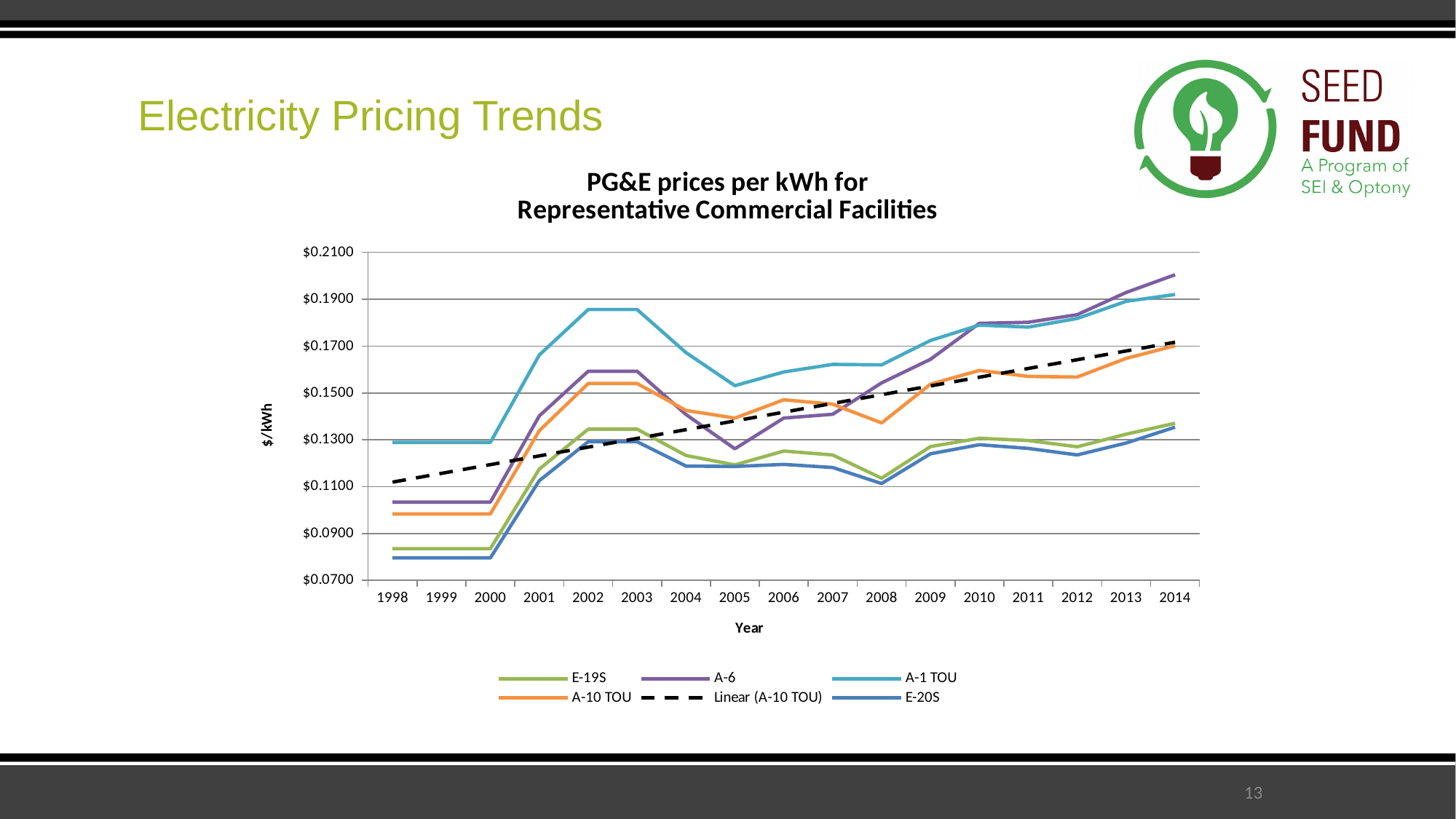
Does the A-1 TOU series rise or fall overall from 1998 to 2014? Rise How many series does the legend list? 6 How many years are plotted along the x axis? 17 Is the value for A-6 in 2005 greater or less than $0.1300? less Is the value for E-20S in 1998 greater or less than $0.0900? less Which series has the lowest value in 1998? E-20S Is the value for A-1 TOU in 2002 greater or less than $0.1700? greater Which series has the highest value in 2014? A-6 What kind of chart is shown on the slide? Line chart Which series has the highest value in 2002? A-1 TOU What is the label on the y axis of the chart? $/kWh Which is larger in 2003, the value for A-1 TOU or the value for E-20S? A-1 TOU